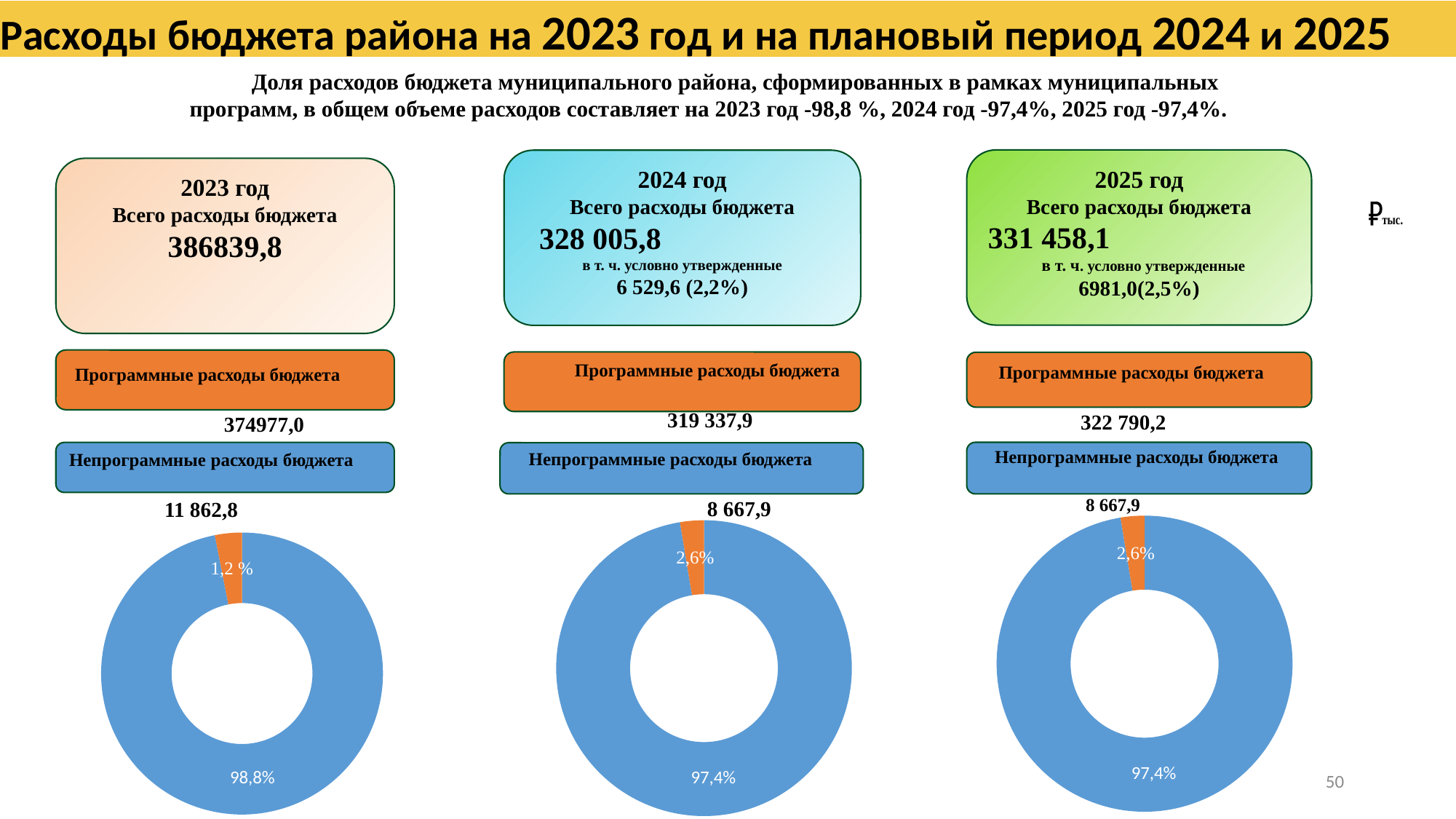
In the left donut chart (2023), what share is shown for the small orange slice? 1,2 % In the left donut chart (2023), which slice is larger, the blue one or the orange one? The blue one In the right donut chart (2025), what share is shown for the orange slice? 2,6% In the right donut chart (2025), what share is shown for the blue slice? 97,4% What kind of chart is the left chart under the 2023 year block? Donut (pie) chart How many donut charts are shown on the slide? 3 How many slices does the left donut chart (2023) have? 2 What colour is the slice labelled 98,8% in the left donut chart (2023)? Blue